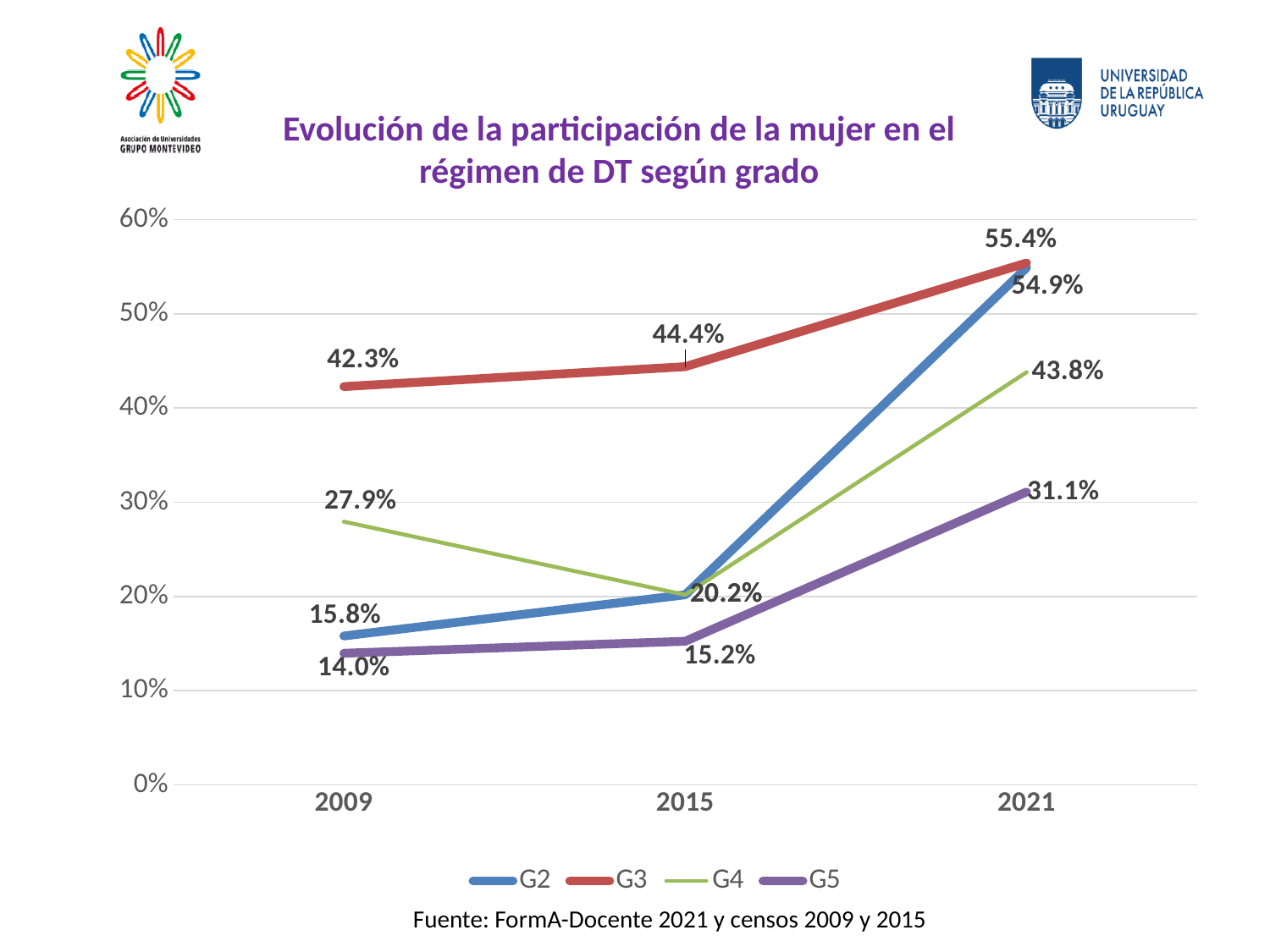
Which series has the lowest value in 2021? G5 What is the value for G3 in 2009? 42.3% What is the value for G4 in 2009? 27.9% What is the value for G5 in 2015? 15.2% Which series has the highest value in 2009? G3 What is the value for G2 in 2021? 54.9% By how many percentage points did G3 increase from 2009 to 2021? 13.1 percentage points How many series does the legend list? 4 What is the value for G4 in 2021? 43.8% What kind of chart is shown on the slide? line chart Is the value for G4 in 2015 greater or less than 30%? less What is the value for G3 in 2021? 55.4%